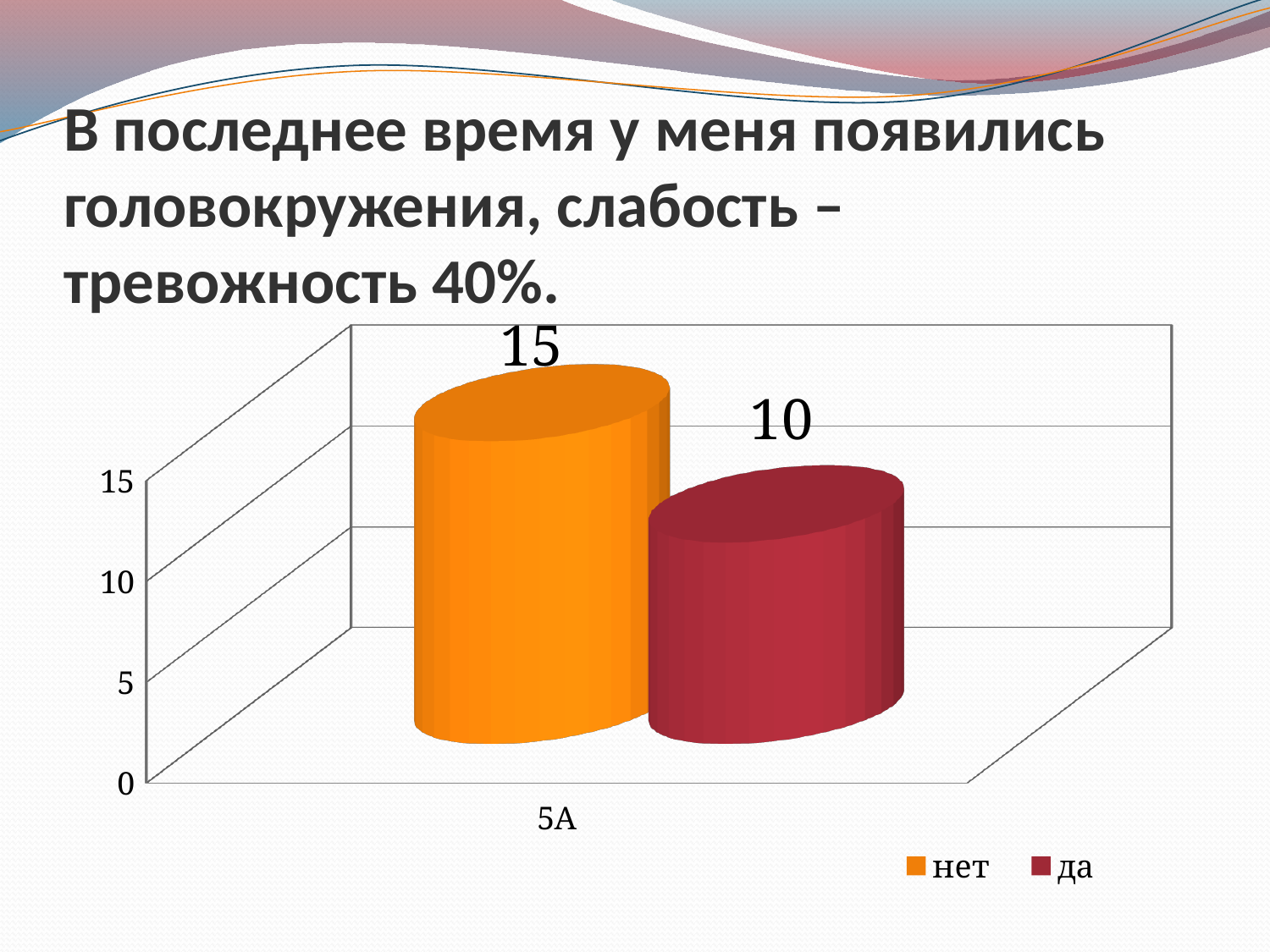
What is the category label on the x axis? 5А Which colour represents the "да" series? red How many series does the legend list? 2 What is the value for "да" in the 5А category? 10 What is the total of the "нет" and "да" values? 25 Is the value for "да" greater or less than 15? less What is the value for "нет" in the 5А category? 15 Which series has the higher value: "нет" or "да"? нет How many categories are shown on the x axis? 1 What kind of chart is shown on the slide? bar chart What is the difference between the "нет" and "да" values? 5 Which series has the lowest value? да